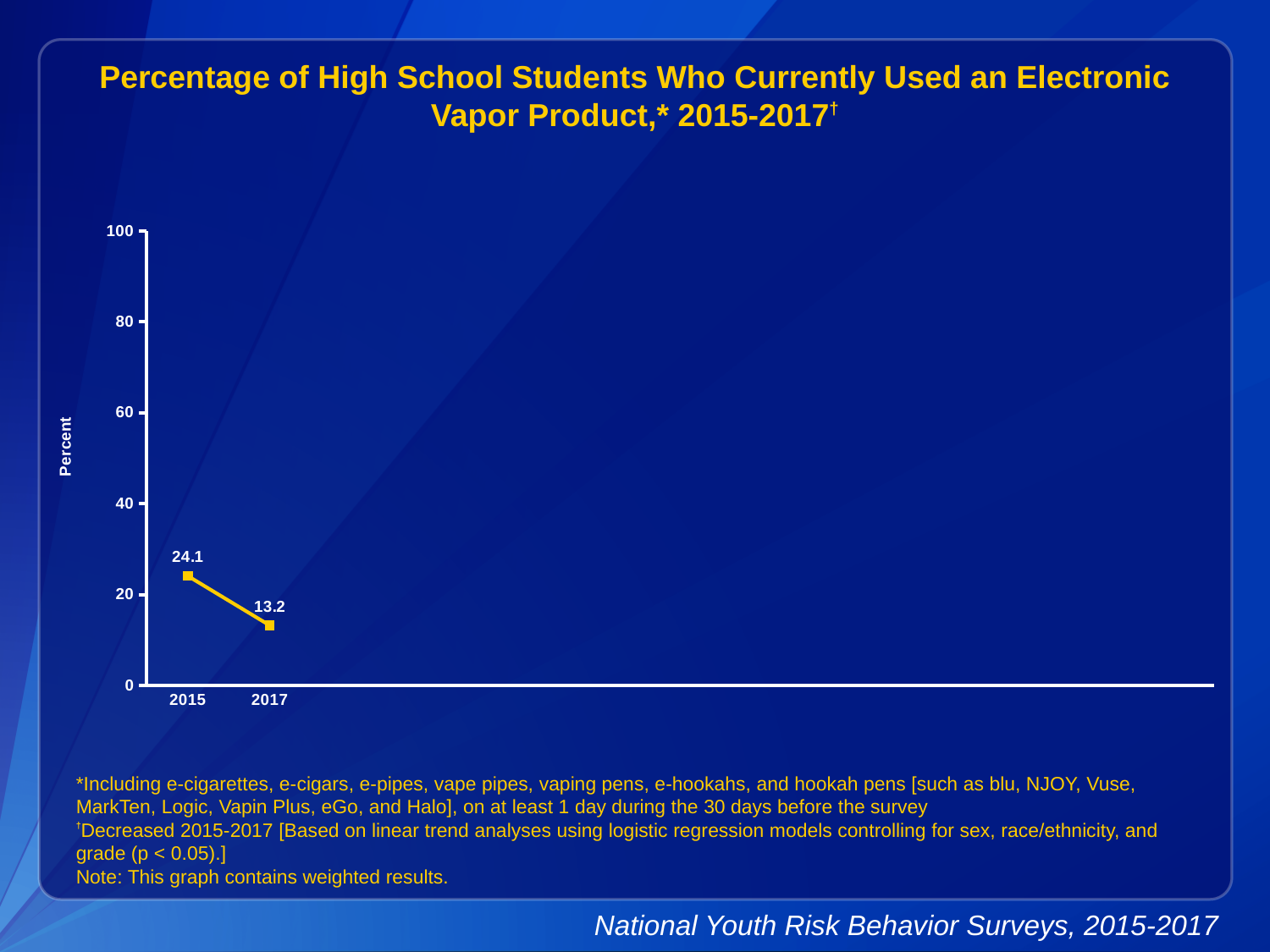
Is the value for 2015 greater or less than 20? greater Which year has the lower percentage of students who currently used an electronic vapor product? 2017 Is the value for 2017 greater or less than 20? less What is the label on the vertical axis of the chart? Percent What percentage of high school students currently used an electronic vapor product in 2015? 24.1 How many data points are plotted on the chart? 2 What kind of chart is shown on the slide? line chart Do the values rise or fall from 2015 to 2017? fall What percentage of high school students currently used an electronic vapor product in 2017? 13.2 By how many percentage points did the value change from 2015 to 2017? 10.9 Which year has the higher percentage of students who currently used an electronic vapor product? 2015 Is the value for 2015 larger or smaller than the value for 2017? larger